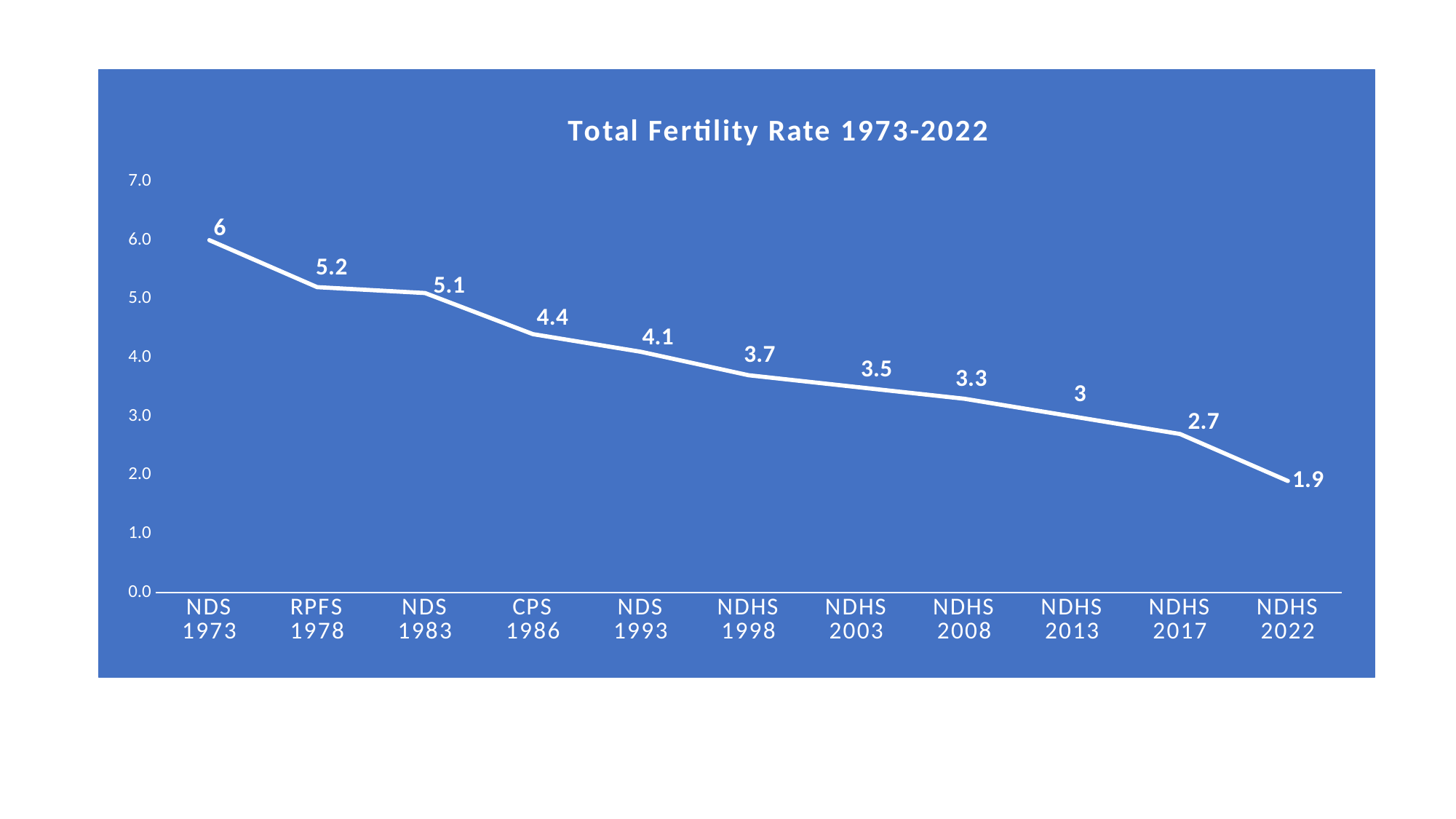
Which is larger, the total fertility rate for RPFS 1978 or NDHS 1998? RPFS 1978 Which survey has the highest total fertility rate? NDS 1973 What is the total fertility rate for NDHS 2022? 1.9 Do the total fertility rate values rise or fall from NDS 1973 to NDHS 2022? Fall Which survey has the lowest total fertility rate? NDHS 2022 What is the total fertility rate for NDHS 2013? 3 What kind of chart is shown on the slide? Line chart What is the total fertility rate for NDS 1973? 6 What is the difference between the total fertility rate for NDS 1993 and NDHS 2017? 1.4 What is the total fertility rate for CPS 1986? 4.4 How many survey points are plotted on the chart? 11 What is the difference between the total fertility rate for NDS 1973 and NDHS 2022? 4.1